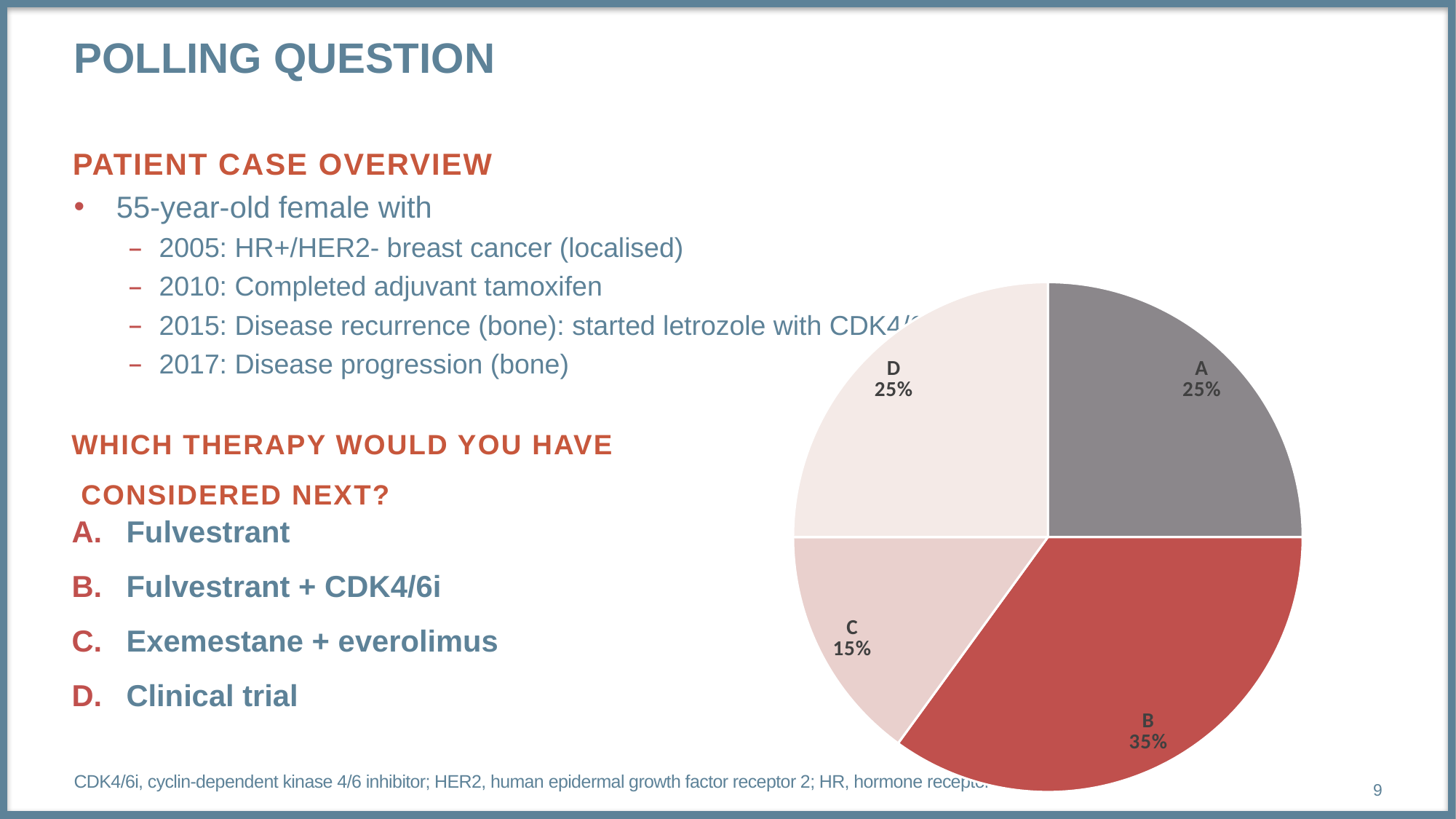
Which slice has the smallest share of the pie? C How many slices does the pie chart have? 4 Which slice has the largest share of the pie? B What kind of chart is shown on the slide? pie chart What is the value for slice C? 15% What is the value for slice D? 25% Which slice of the pie chart is coloured red? B What is the value for slice A? 25% What is the difference between the values for B and C? 20% What is the value for slice B? 35% What is the difference between the values for A and C? 10% Which is larger, the value for B or the value for A? B